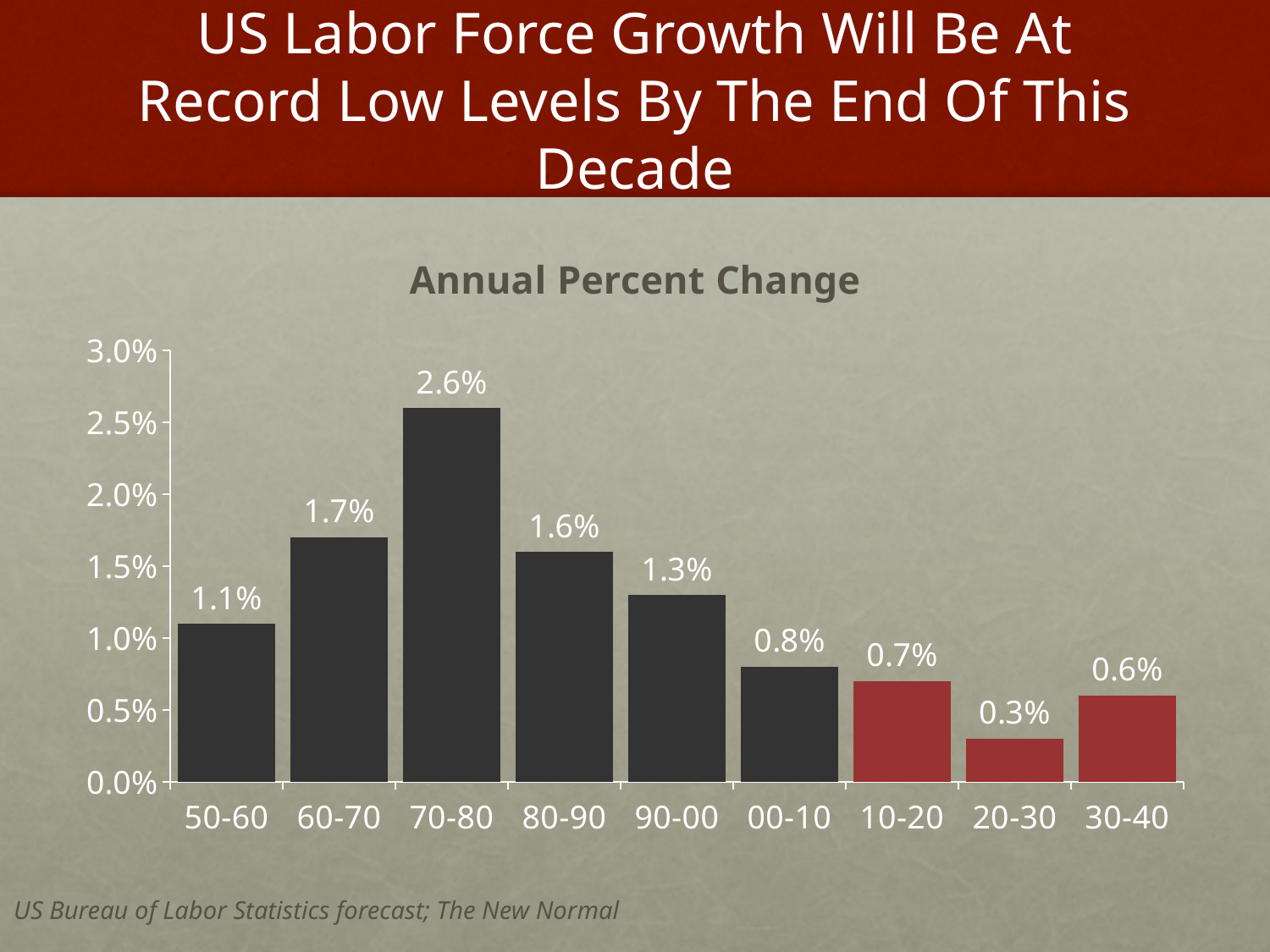
What is the difference between the annual percent change for 70-80 and 80-90? 1.0% Which decade has the highest annual percent change? 70-80 Is the value for 10-20 greater or less than 1.0%? less Which is larger, the annual percent change for 60-70 or for 00-10? 60-70 How many decades are shown on the x axis? 9 What is the annual percent change for 70-80? 2.6% What is the annual percent change for 20-30? 0.3% What is the title of the chart? Annual Percent Change What kind of chart is shown on the slide? bar chart What is the annual percent change for 90-00? 1.3% What is the difference between the annual percent change for 50-60 and 30-40? 0.5% Which decade has the lowest annual percent change? 20-30